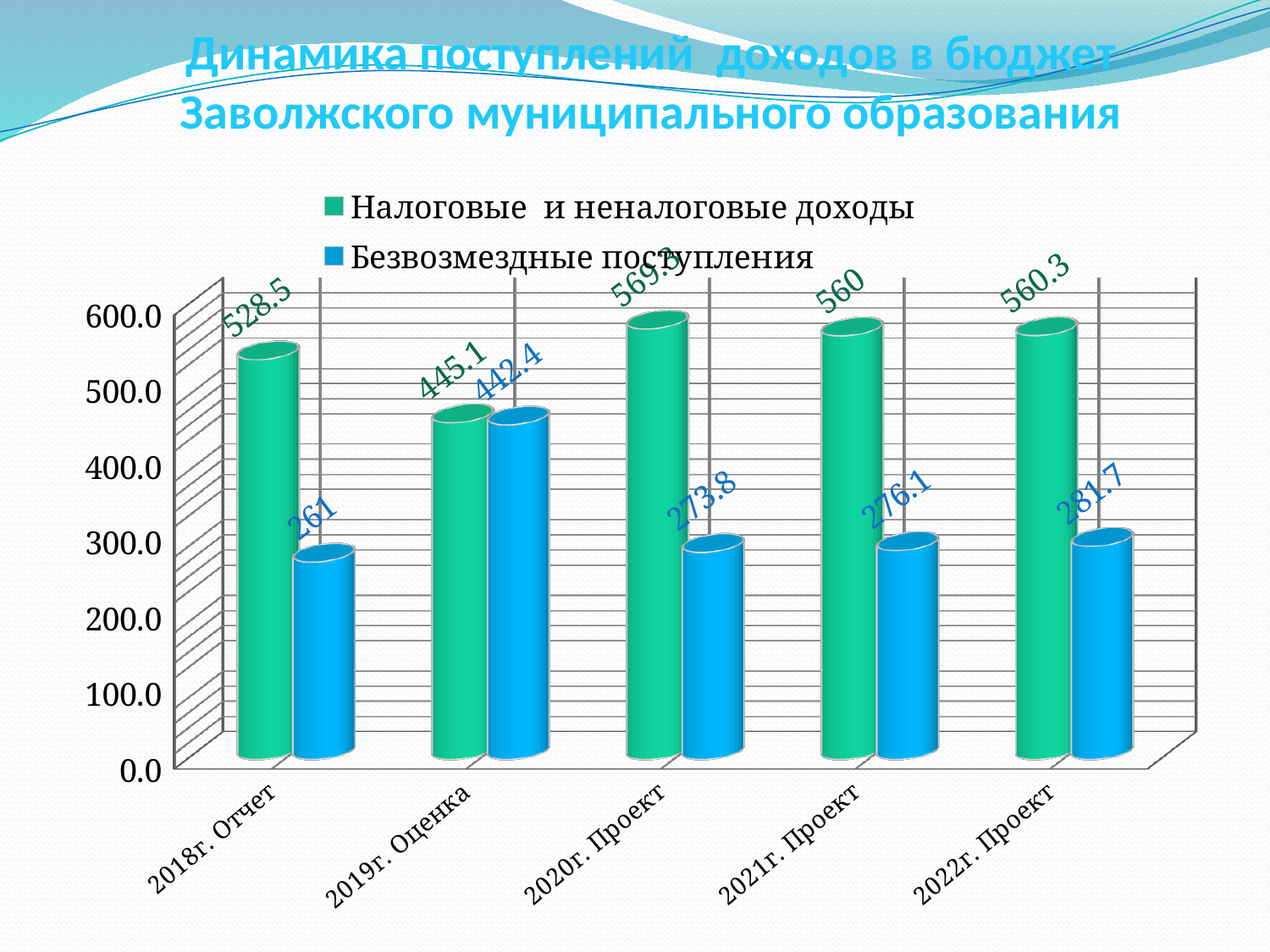
What is the value of Безвозмездные поступления for 2019г. Оценка? 442.4 How many series does the legend list? 2 Which category has the lowest value for Безвозмездные поступления? 2018г. Отчет Which is larger: Налоговые и неналоговые доходы for 2018г. Отчет or for 2019г. Оценка? 2018г. Отчет What is the value of Налоговые и неналоговые доходы for 2018г. Отчет? 528.5 Which category has the highest value for Безвозмездные поступления? 2019г. Оценка What kind of chart is shown on the slide? Bar chart Which category has the lowest value for Налоговые и неналоговые доходы? 2019г. Оценка How many categories are shown on the x axis? 5 What is the value of Безвозмездные поступления for 2022г. Проект? 281.7 What is the difference between Безвозмездные поступления for 2022г. Проект and 2018г. Отчет? 20.7 What is the value of Налоговые и неналоговые доходы for 2021г. Проект? 560